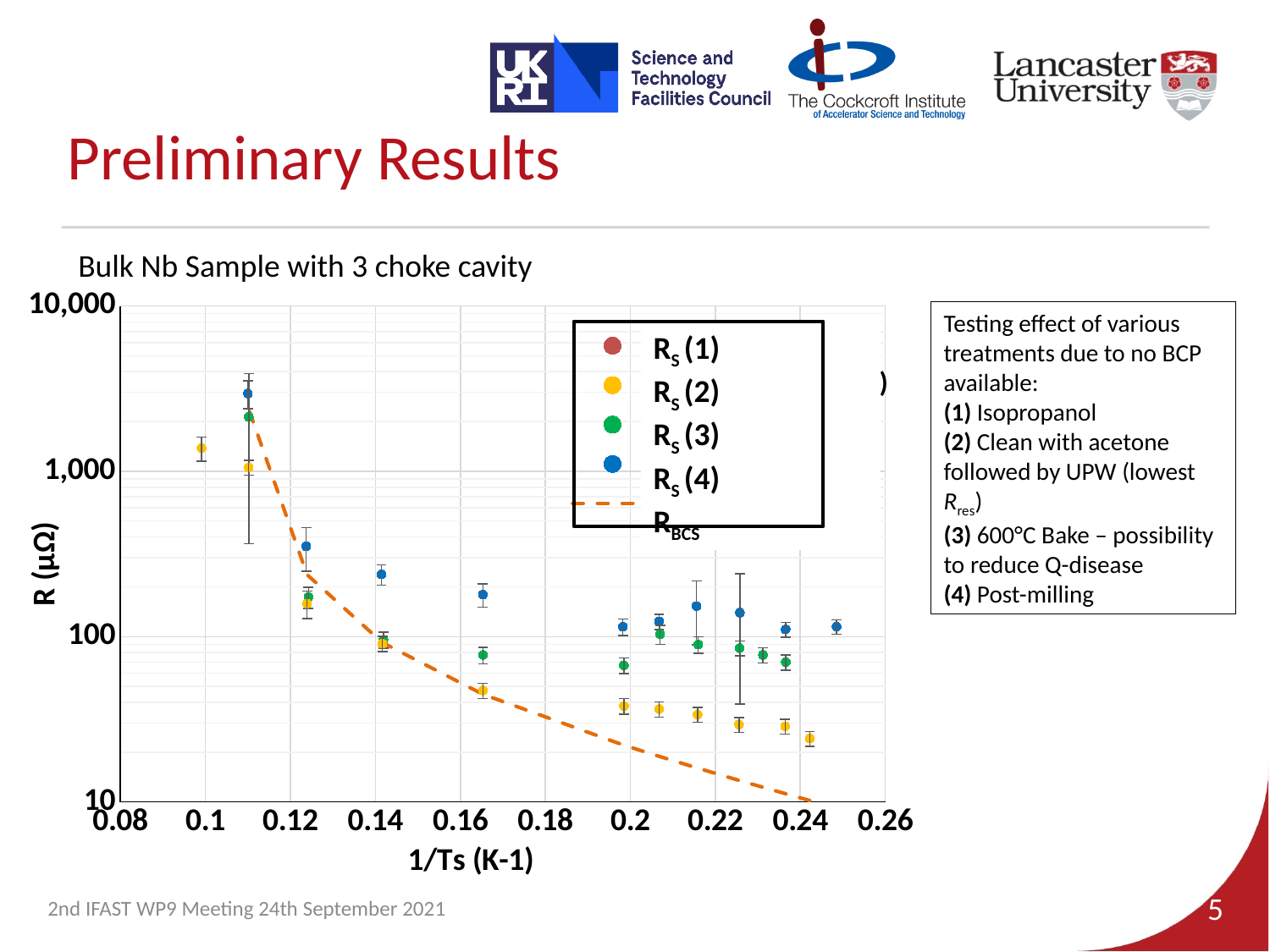
Is the R_S (4) value at 1/Ts = 0.22 greater or less than 100? greater What kind of chart is shown on the slide? Scatter chart How many series does the chart legend list? 5 Is the R_S (2) value at 1/Ts = 0.1 greater or less than 1,000? greater What is the title of the chart? Bulk Nb Sample with 3 choke cavity At 1/Ts = 0.2, which series has the larger value, R_S (4) or R_S (2)? R_S (4) What is the label of the y axis of the chart? R (μΩ) Do the R_S (2) values rise or fall as 1/Ts increases along the x axis? fall Is the R_BCS dashed line at 1/Ts = 0.22 greater or less than 100? less